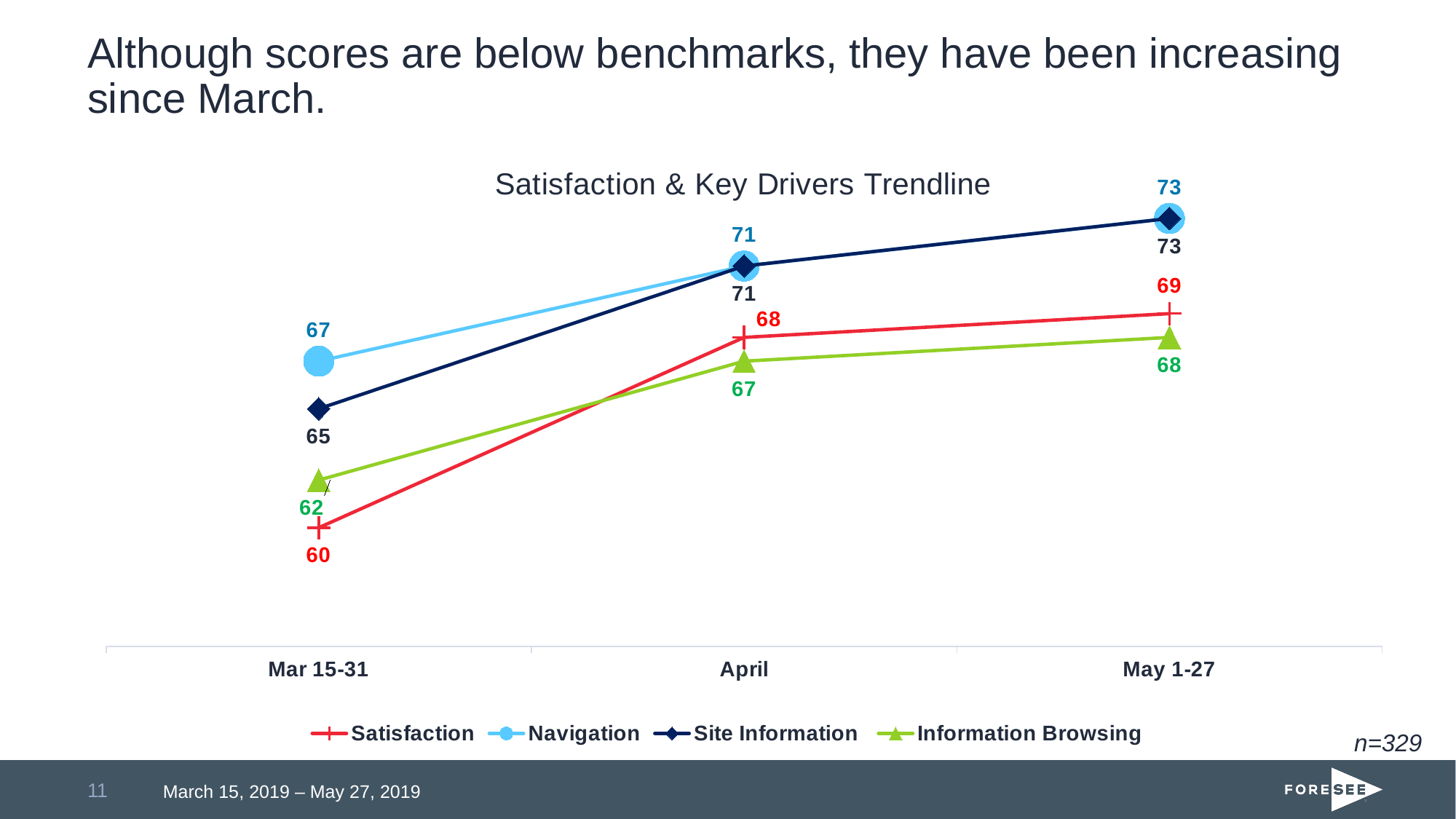
What is the Site Information score for Mar 15-31? 65 By how much did the Satisfaction score increase from Mar 15-31 to May 1-27? 9 Which is larger in April: the Satisfaction score or the Information Browsing score? Satisfaction What is the Satisfaction score for Mar 15-31? 60 What is the Navigation score for May 1-27? 73 What kind of chart is shown on the slide? Line chart How many time periods are shown on the x axis? 3 Which series has the lowest score in Mar 15-31? Satisfaction What is the Information Browsing score for April? 67 Which series has the highest score in Mar 15-31? Navigation What is the difference between the Navigation and Information Browsing scores in April? 4 How many series does the legend list? 4